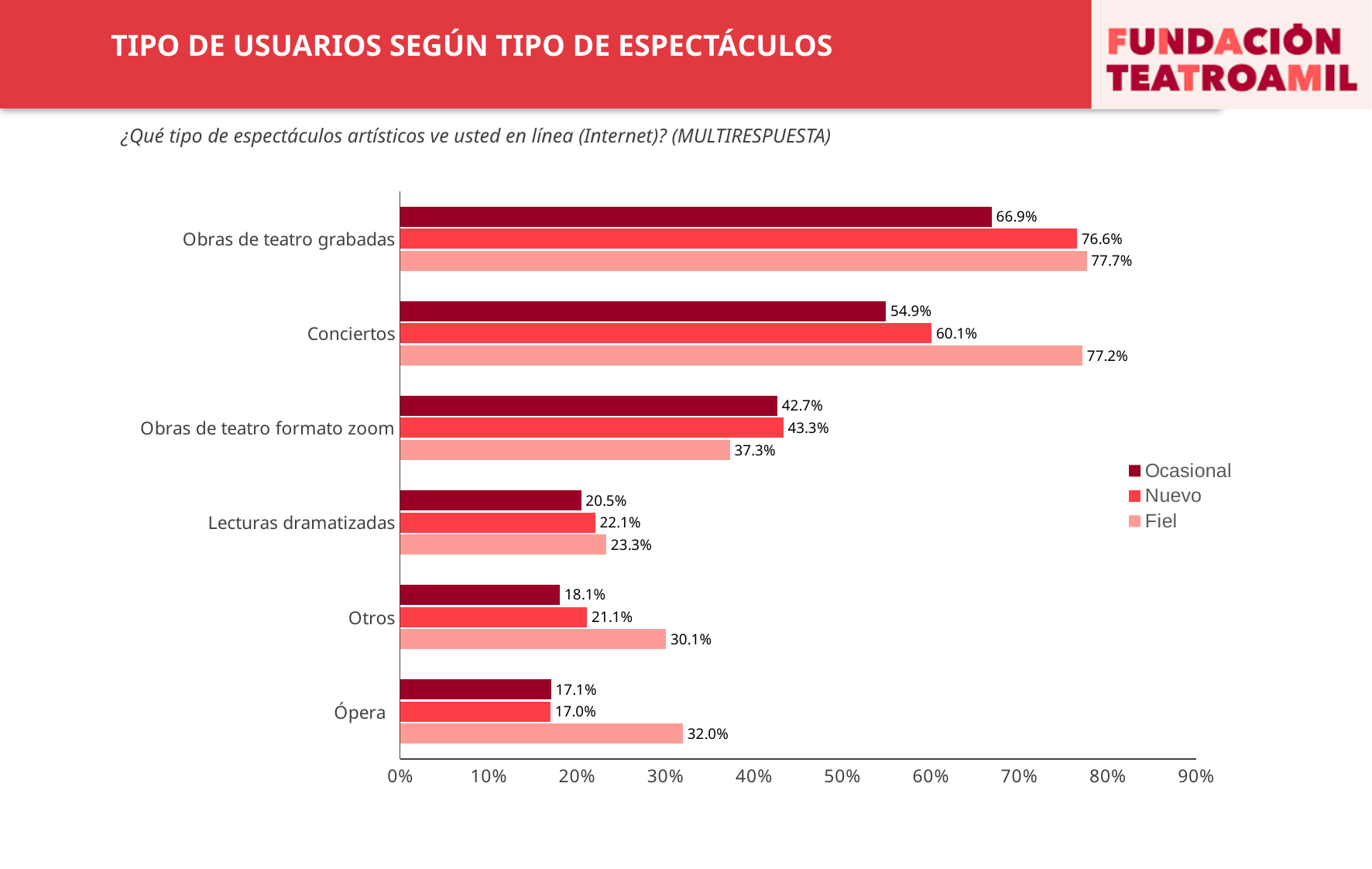
How many categories are shown on the chart? 6 What is the value for Ocasional in the Obras de teatro grabadas category? 66.9% What is the difference between the Fiel and Ocasional values for Ópera? 14.9% What is the value for Fiel in the Conciertos category? 77.2% What is the difference between the Fiel and Nuevo values for Conciertos? 17.1% Which series is shown in the darkest red colour in the legend? Ocasional What kind of chart is shown on the slide? Bar chart Which category has the lowest value for the Nuevo series? Ópera Which is larger for Obras de teatro formato zoom: the Nuevo value or the Fiel value? Nuevo Which category has the highest value for the Fiel series? Obras de teatro grabadas What is the value for Nuevo in the Ópera category? 17.0% How many series does the legend list? 3